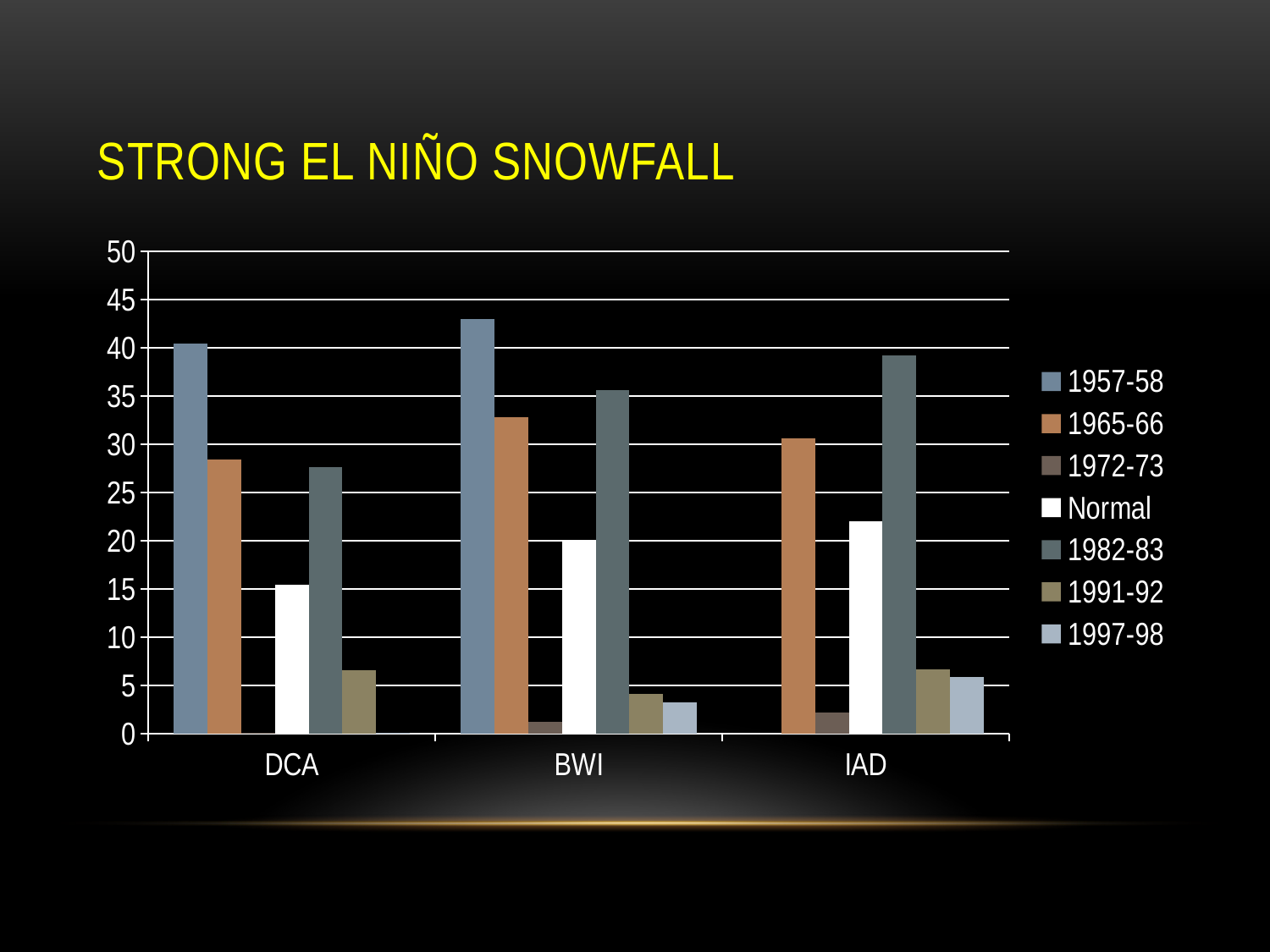
Is the 1957-58 value for DCA greater or less than 35? greater Is the Normal value for BWI greater or less than 25? less How many airport categories are shown on the x axis? 3 At BWI, which series has the lowest bar? 1972-73 Which category has the highest 1957-58 bar? BWI For the 1982-83 series, which is larger: the value at IAD or the value at BWI? IAD At DCA, which is larger: the 1965-66 value or the Normal value? 1965-66 At IAD, which series has the tallest bar? 1982-83 How many series does the legend list? 7 What kind of chart is shown on the slide? bar chart What is the title of the slide? STRONG EL NIÑO SNOWFALL Is the 1965-66 value for IAD greater or less than 25? greater